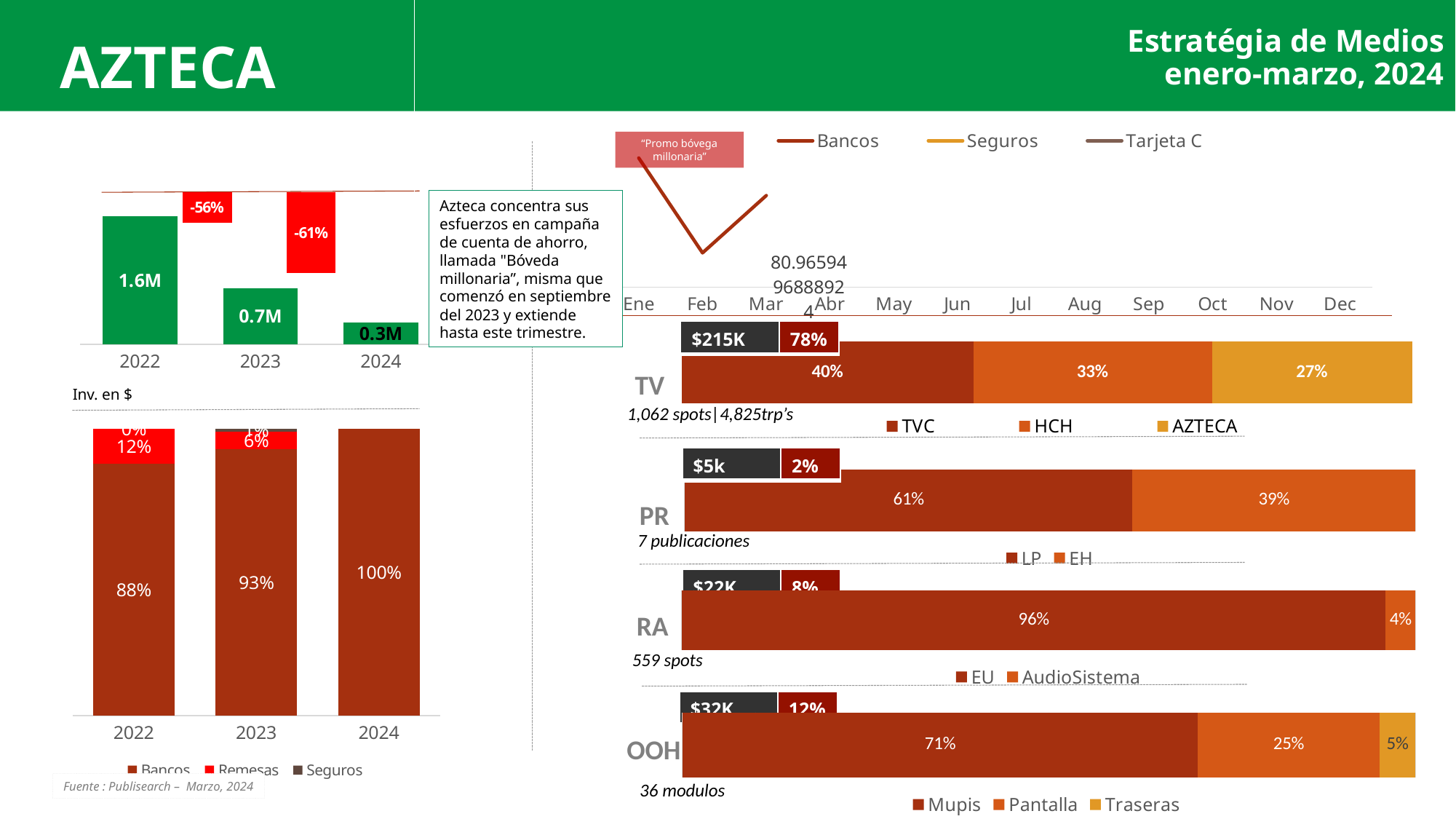
In the bottom-left stacked bar chart 'Inv. en $', what share does Bancos have in 2023? 93% In the TV bar on the right, what share does HCH have? 33% In the TV bar on the right, what is the difference between the TVC share and the AZTECA share? 13% In the top-left bar chart of investment by year, do the values rise or fall from 2022 to 2024? fall In the top-left bar chart of investment by year, what is the value for 2024? 0.3M In the PR bar on the right, which is larger, LP or EH? LP In the bottom-left stacked bar chart 'Inv. en $', what share does Remesas have in 2022? 12% In the top-left bar chart of investment by year, what percentage change is shown between 2022 and 2023? -56% In the OOH bar on the right, what share does Pantalla have? 25% In the top-left bar chart of investment by year, what is the value for 2022? 1.6M In the bottom-left stacked bar chart 'Inv. en $', how many series does the legend list? 3 In the top-left bar chart of investment by year, which year has the lowest value? 2024